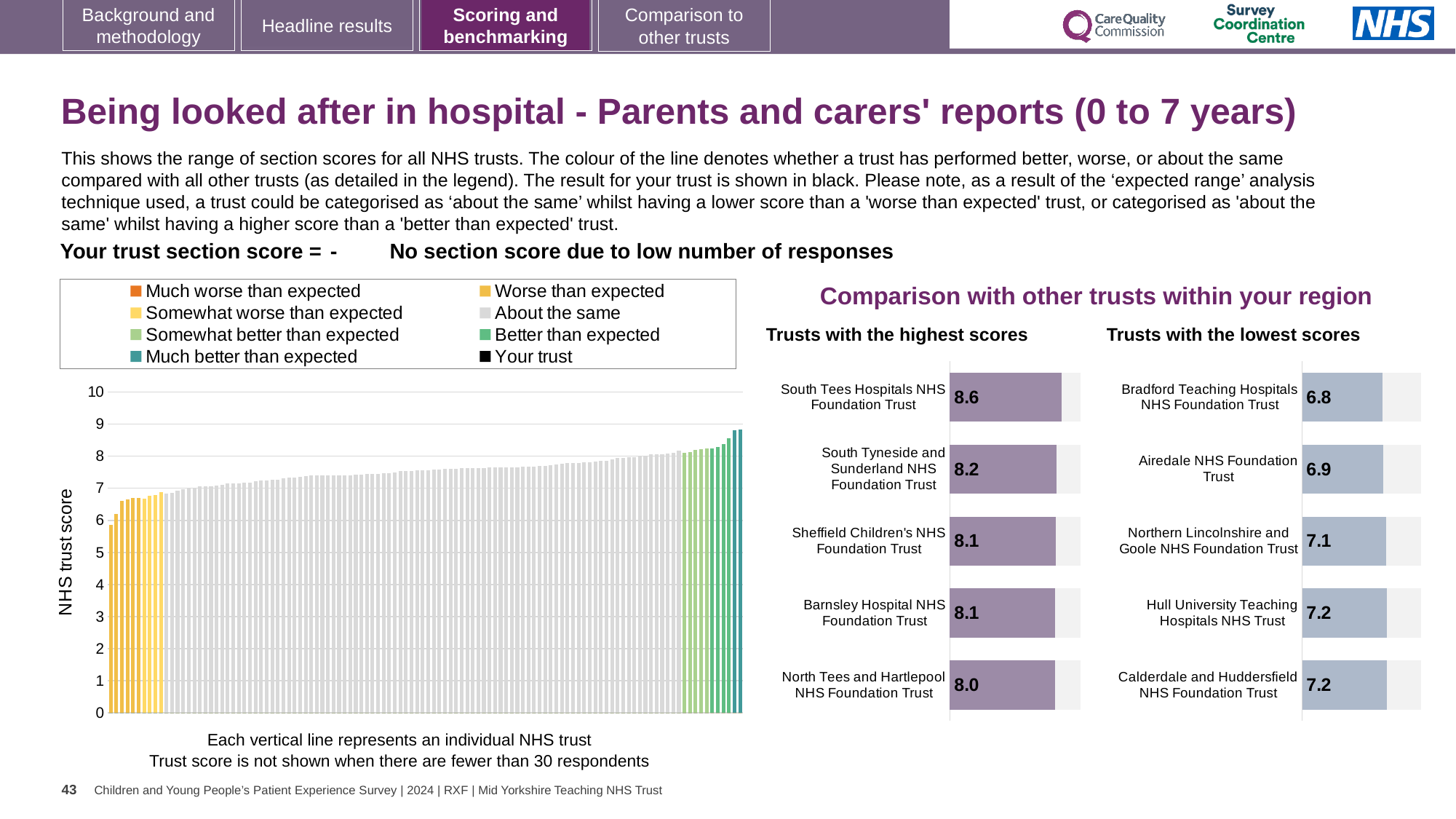
In the 'Trusts with the highest scores' chart, which trust has the highest score? South Tees Hospitals NHS Foundation Trust In the 'Trusts with the lowest scores' chart, which trust has the lowest score? Bradford Teaching Hospitals NHS Foundation Trust In the large chart on the left, do the trust scores rise or fall from left to right? Rise How many trusts are listed in the 'Trusts with the lowest scores' chart? 5 In the 'Trusts with the highest scores' chart, what is the score for South Tees Hospitals NHS Foundation Trust? 8.6 In the 'Trusts with the lowest scores' chart, which has the larger score: Northern Lincolnshire and Goole NHS Foundation Trust or Bradford Teaching Hospitals NHS Foundation Trust? Northern Lincolnshire and Goole NHS Foundation Trust What kind of chart is the large chart on the left showing the range of section scores for all NHS trusts? Bar chart What is the y-axis label of the large chart on the left? NHS trust score How many entries does the legend above the large chart on the left list? 8 In the large chart on the left, is the value of the tallest bar greater or less than 8? greater In the 'Trusts with the lowest scores' chart, what is the score for Airedale NHS Foundation Trust? 6.9 In the 'Trusts with the highest scores' chart, what is the difference between the scores of South Tees Hospitals NHS Foundation Trust and North Tees and Hartlepool NHS Foundation Trust? 0.6